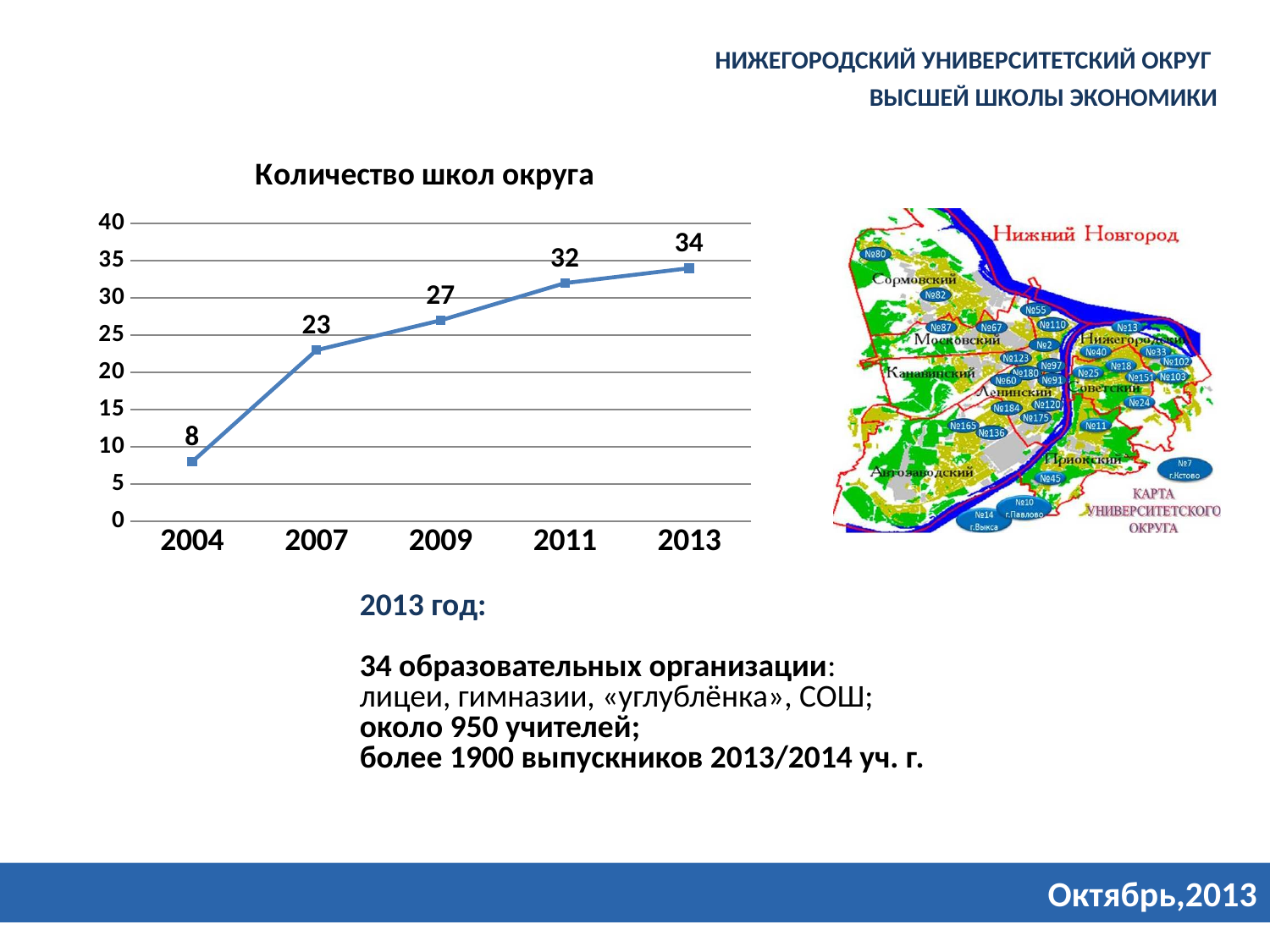
Which year has the highest number of schools? 2013 How many years are plotted on the chart? 5 What is the difference between the number of schools in 2011 and in 2007? 9 What kind of chart is shown? line chart What is the difference between the number of schools in 2013 and in 2004? 26 Does the number of schools rise or fall from 2004 to 2013? rise What is the number of schools in 2004? 8 Is the number of schools in 2009 greater or less than 25? greater What is the number of schools in 2009? 27 Which year has more schools, 2007 or 2011? 2011 What is the number of schools in 2013? 34 Which year has the lowest number of schools? 2004